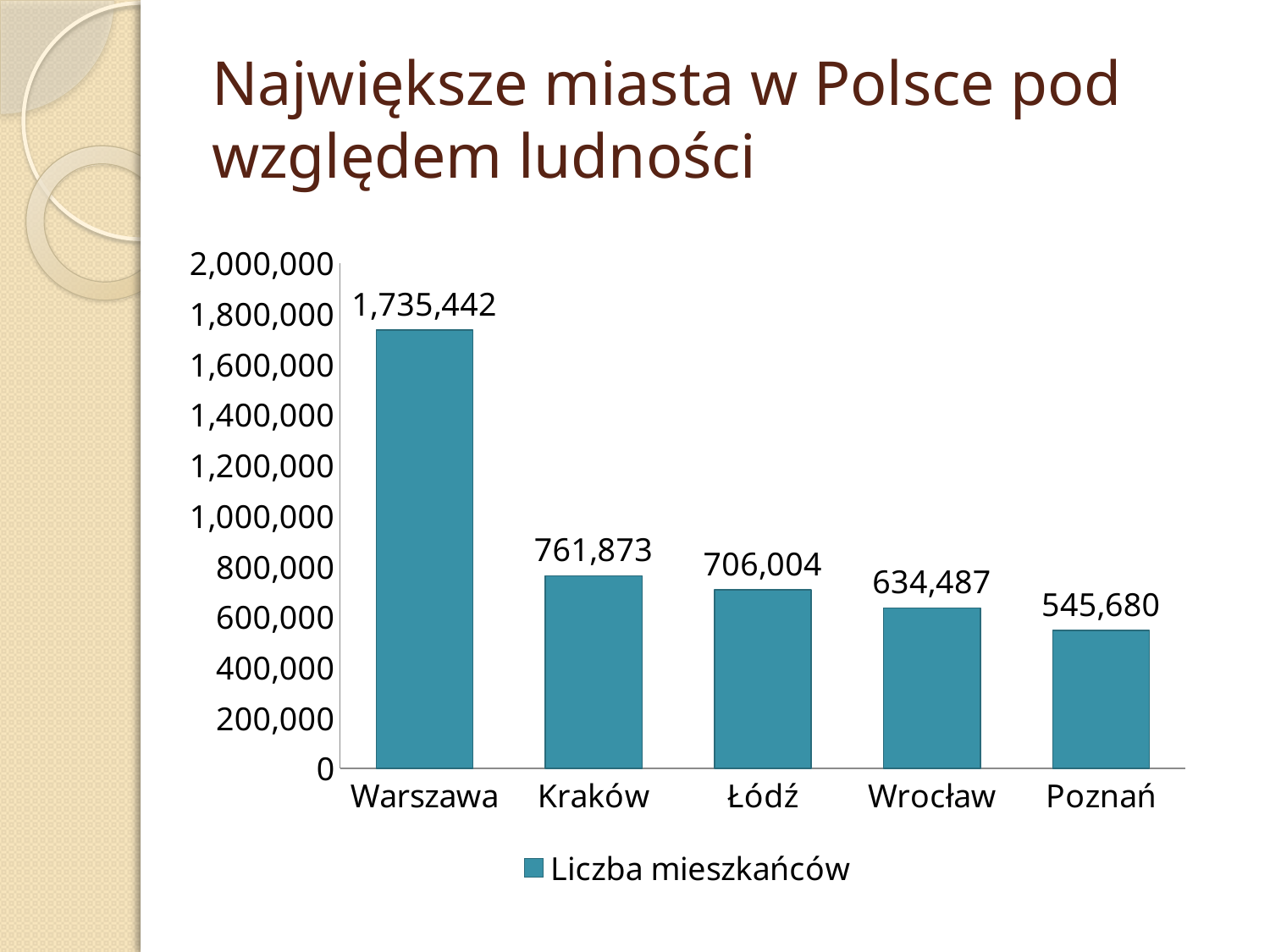
Is the value for Wrocław greater or less than 800,000? less What is the name of the series listed in the legend? Liczba mieszkańców Which is larger, the value for Kraków or the value for Łódź? Kraków What is the value for Łódź? 706,004 Which city has the highest value? Warszawa What is the difference between the values for Warszawa and Kraków? 973,569 Which city has the lowest value? Poznań How many cities are shown on the chart? 5 What kind of chart is shown on the slide? bar chart What is the difference between the values for Wrocław and Poznań? 88,807 What is the value for Warszawa? 1,735,442 What is the value for Poznań? 545,680